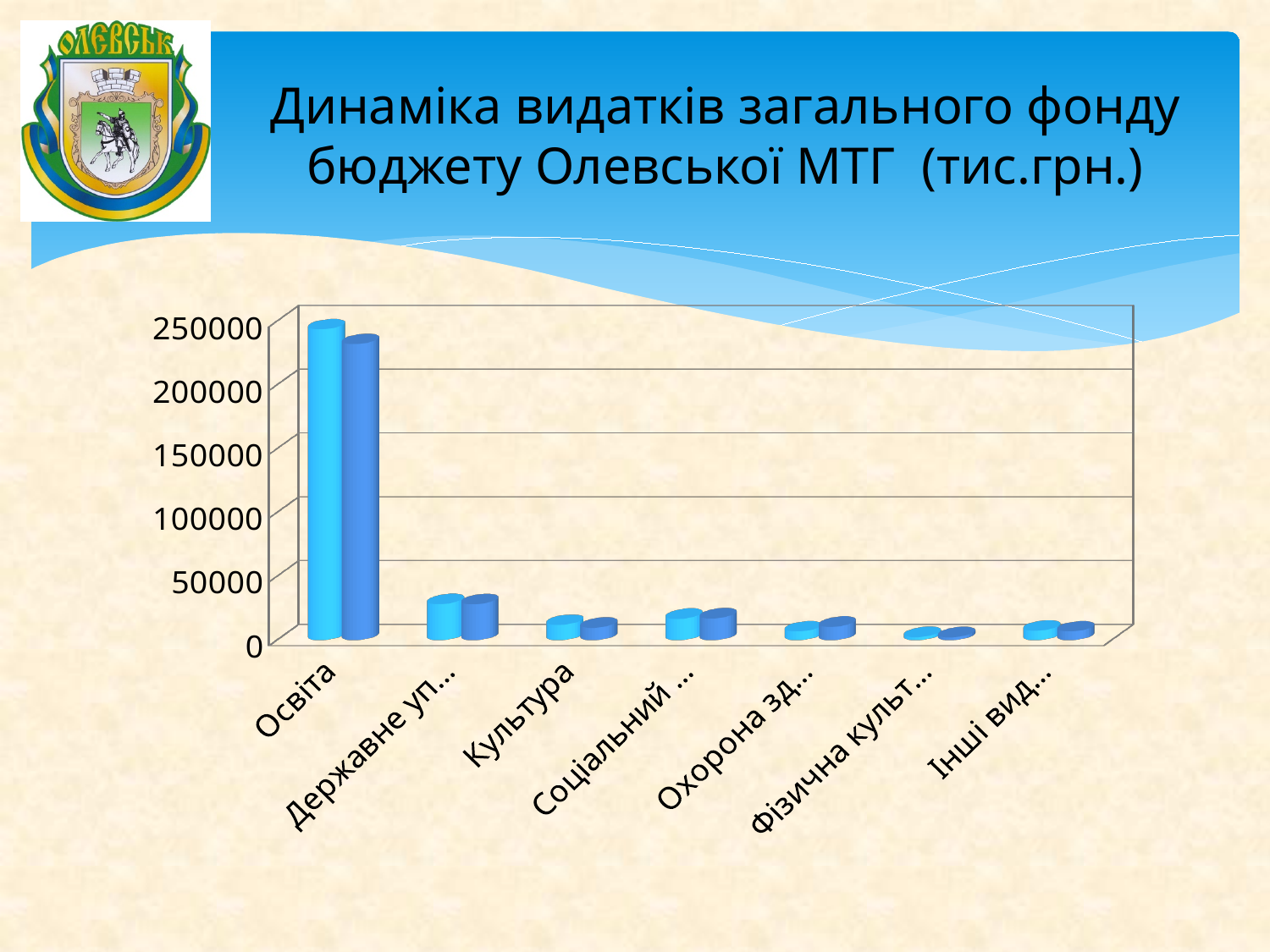
Is the value of the light blue bar for Культура greater or less than 50000? less Is the value of the dark blue bar for Освіта greater or less than 200000? greater How many bars are shown for the category Освіта? 2 Which category has the highest bars in the chart? Освіта How many categories are shown along the x axis of the chart? 7 What kind of chart is shown on the slide? bar chart What is the title of the slide containing the chart? Динаміка видатків загального фонду бюджету Олевської МТГ (тис.грн.) Is the value of the light blue bar for Освіта greater or less than 200000? greater What is the highest tick value shown on the vertical axis? 250000 Which category has larger bars, Освіта or Культура? Освіта